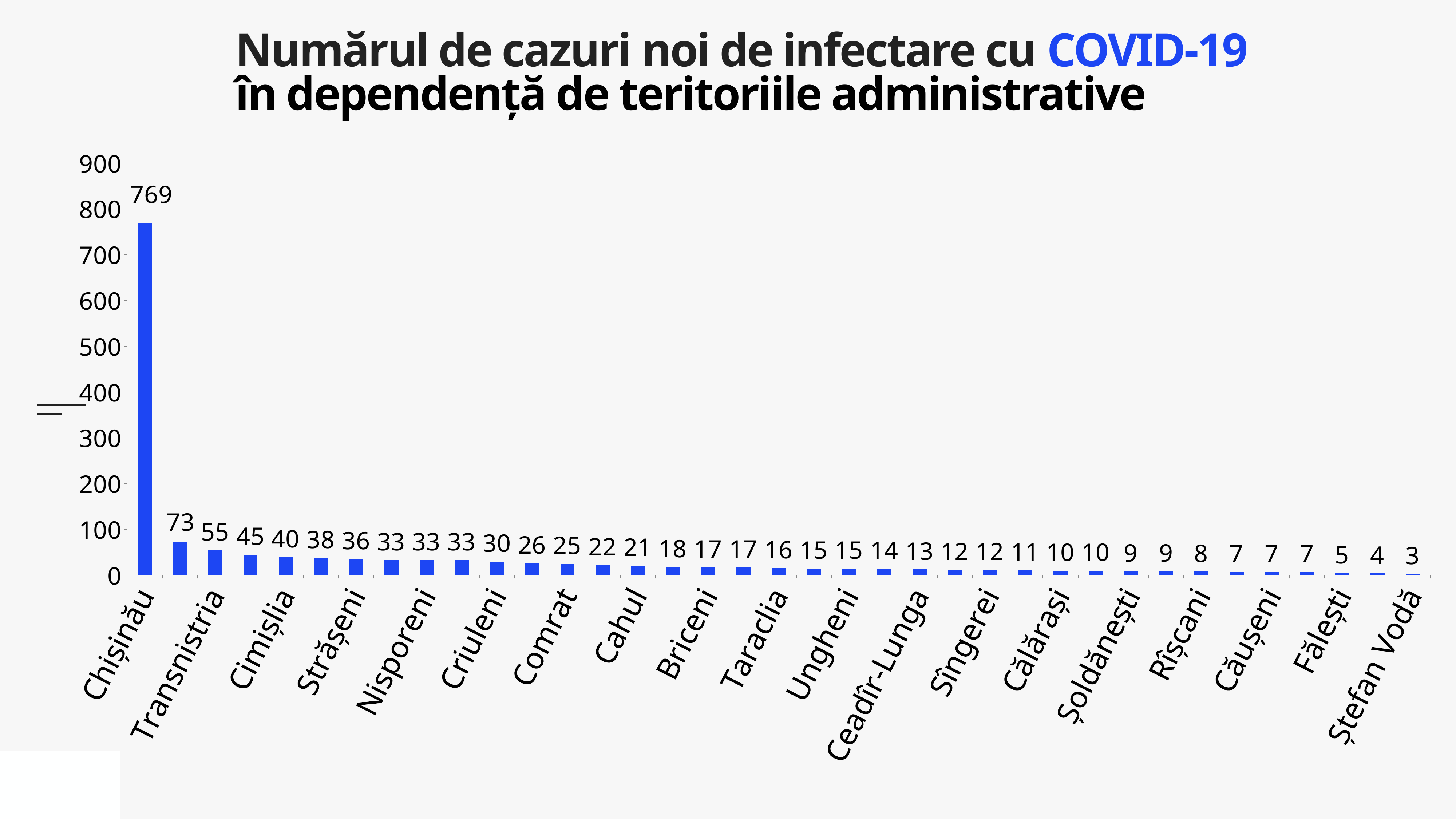
What type of chart is shown on the slide? bar chart Do the values rise or fall from left to right along the x axis? fall What is the difference between the values for Chișinău and Transnistria? 714 Is the value for Chișinău greater or less than 700? greater What colour are the bars in the chart? blue What is the number of new COVID-19 cases for Chișinău? 769 Which has more new cases, Chișinău or Transnistria? Chișinău What is the value shown for Transnistria? 55 Which labelled territory has the lowest number of new cases? Ștefan Vodă What is the value shown for Ștefan Vodă? 3 Which territory has the highest number of new cases? Chișinău What is the highest value shown on the vertical axis? 900